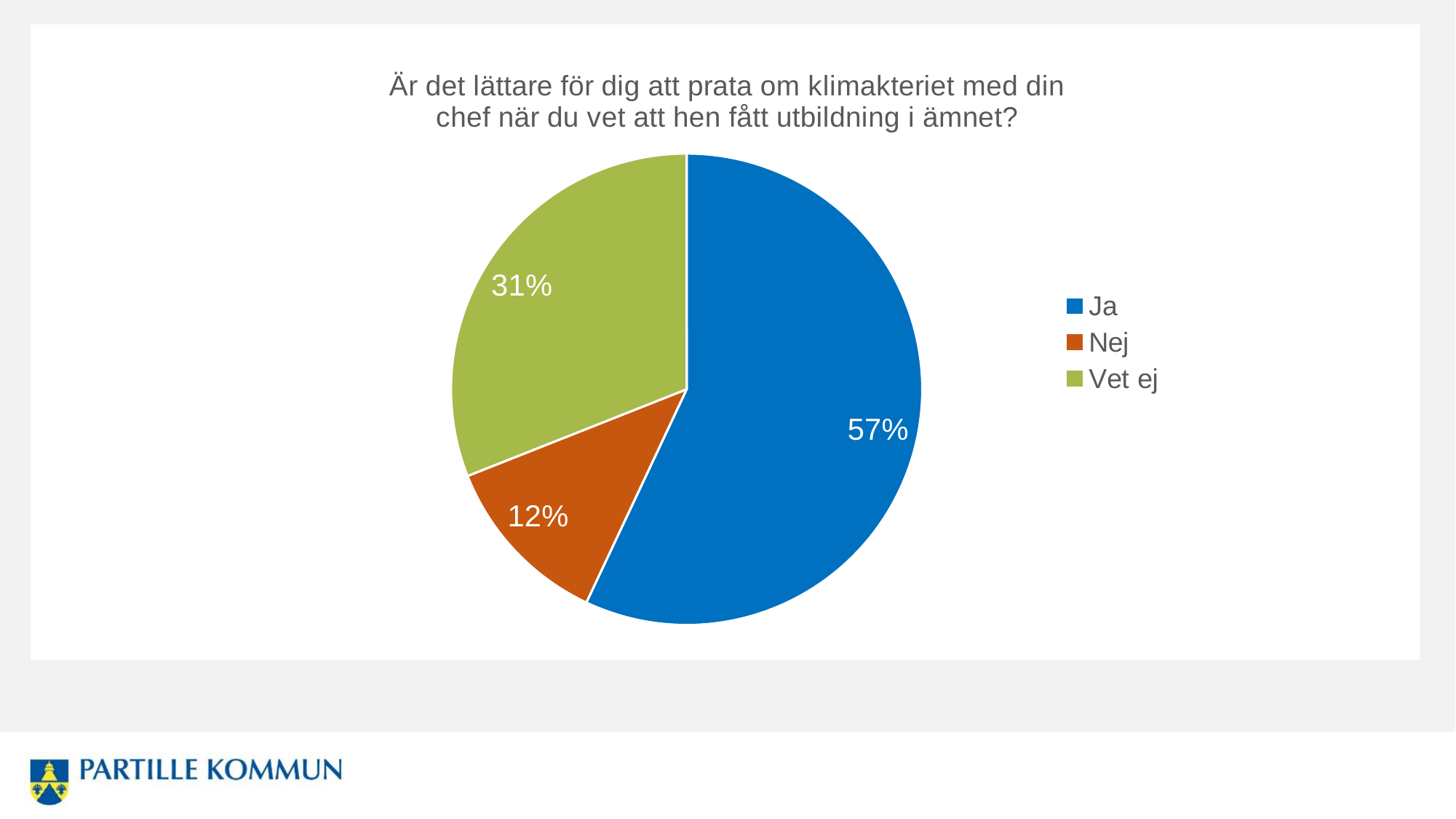
What colour is the "Vet ej" slice? Green What is the difference in percentage points between "Ja" and "Vet ej"? 26 What is the value shown for "Vet ej"? 31% What share of the pie does "Ja" represent? 57% Which is larger, "Vet ej" or "Nej"? Vet ej Which category has the largest slice? Ja What is the difference in percentage points between "Vet ej" and "Nej"? 19 How many entries does the legend list? 3 What is the value shown for "Nej"? 12% What kind of chart is shown on the slide? Pie chart How many slices does the pie chart have? 3 Which category has the smallest slice? Nej